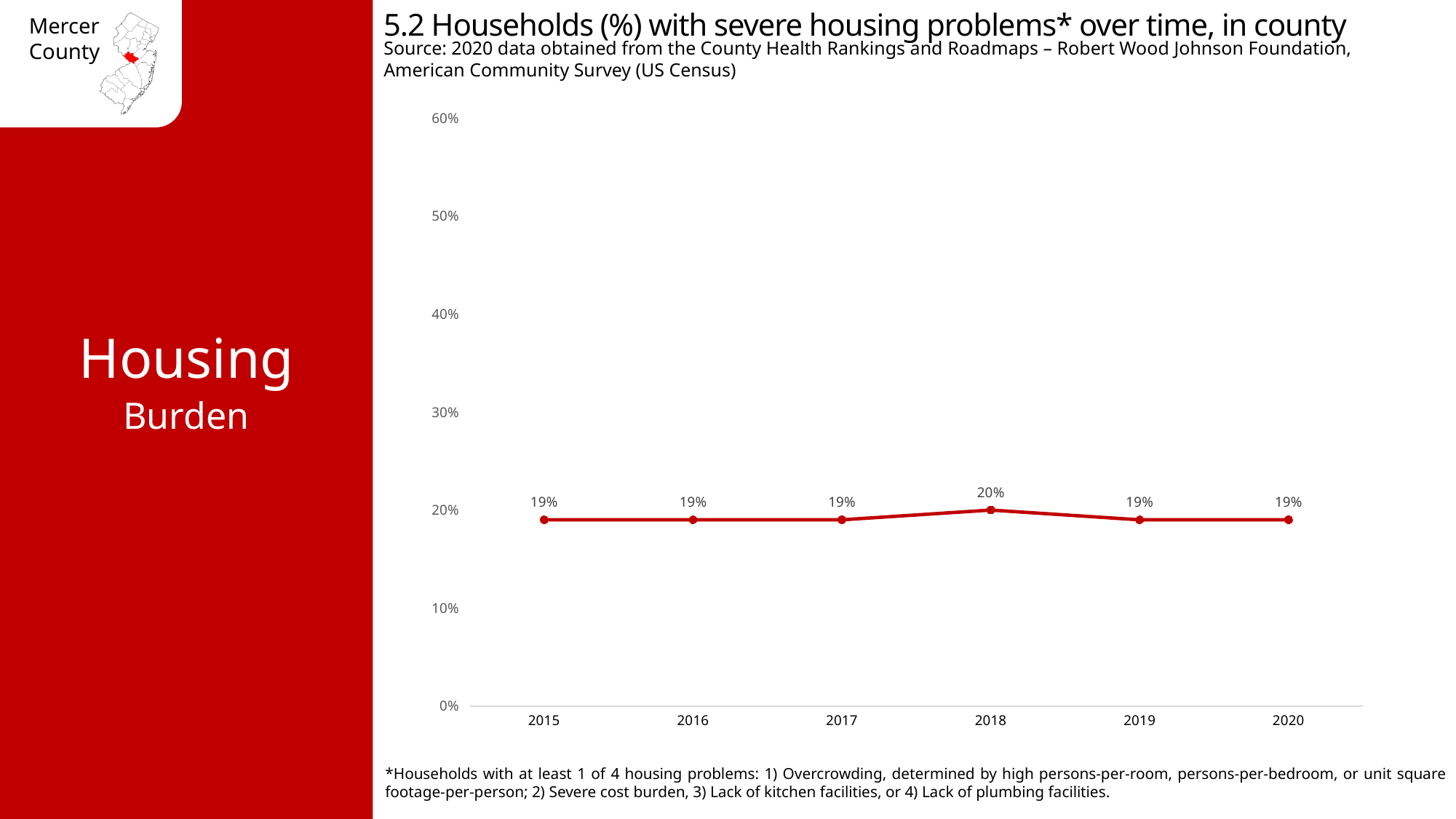
Is the value for 2016 greater or less than 30%? less What is the value shown for 2020? 19% What is the title of the chart? 5.2 Households (%) with severe housing problems* over time, in county What kind of chart is shown on the slide? Line chart What percentage of households had severe housing problems in 2015? 19% What is the difference between the 2018 value and the 2019 value? 1% What is the highest value shown on the y axis? 60% Is the value for 2018 larger than the value for 2017? Yes Which year has the highest percentage of households with severe housing problems? 2018 Does the percentage of households with severe housing problems change substantially from 2015 to 2020? No What percentage of households had severe housing problems in 2018? 20% How many years are plotted on the chart? 6